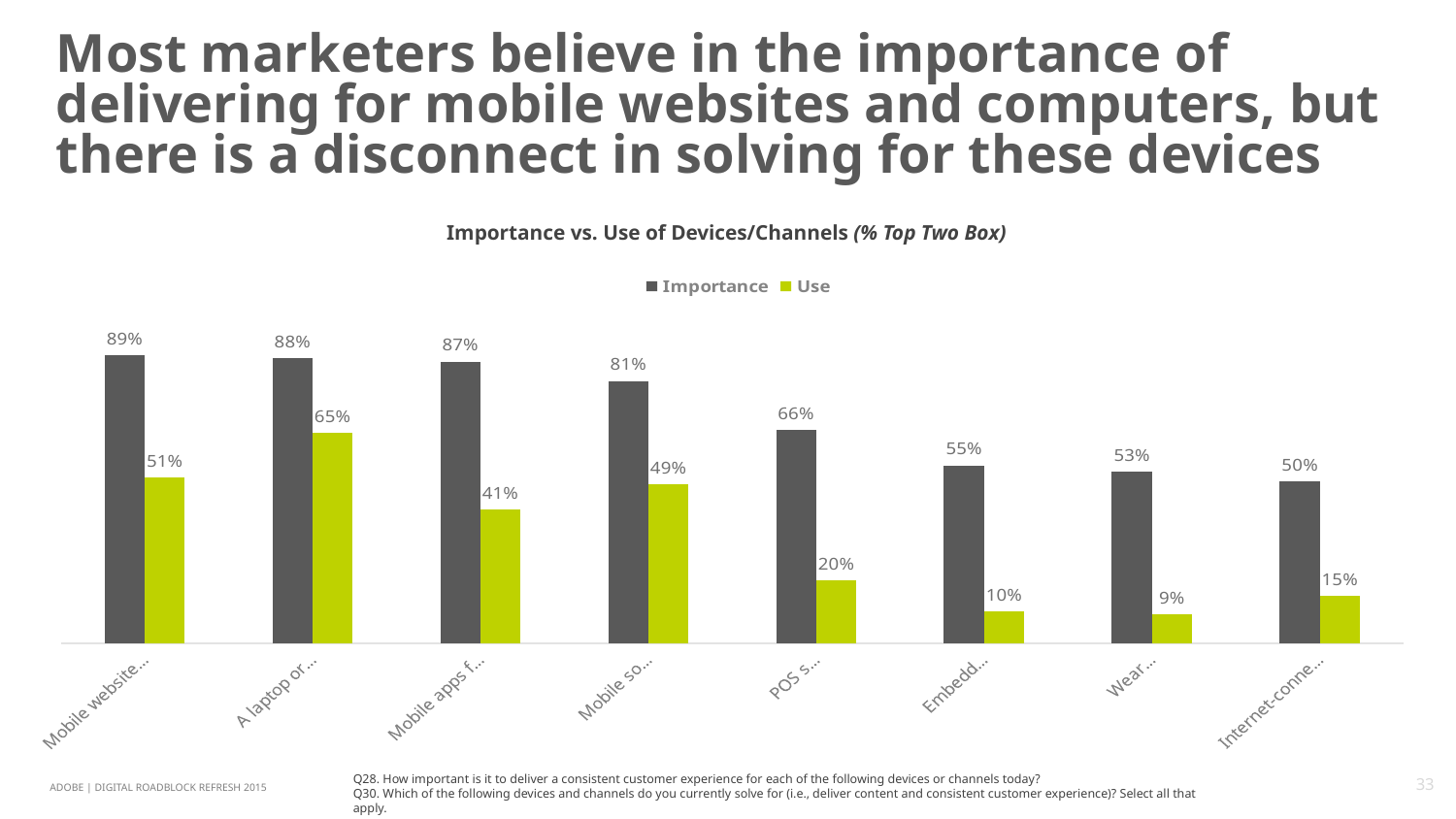
What is the Use value for the category labelled 'Internet-conne...'? 15% Which category has the lowest Use value? Wear... What kind of chart is shown on the slide? Bar chart What is the Importance value for the category labelled 'Mobile website...'? 89% What is the difference between the Importance and Use values for the category labelled 'POS s...'? 46 percentage points What is the Use value for the category labelled 'A laptop or...'? 65% How many series does the legend list in the chart? 2 Which colour represents the Use series in the chart? Green How many device/channel categories are plotted along the x axis? 8 Which category has the highest Use value? A laptop or... Do the Importance values rise or fall moving from left to right along the x axis? Fall Which has the larger Importance value: 'Mobile so...' or 'Embedd...'? Mobile so...